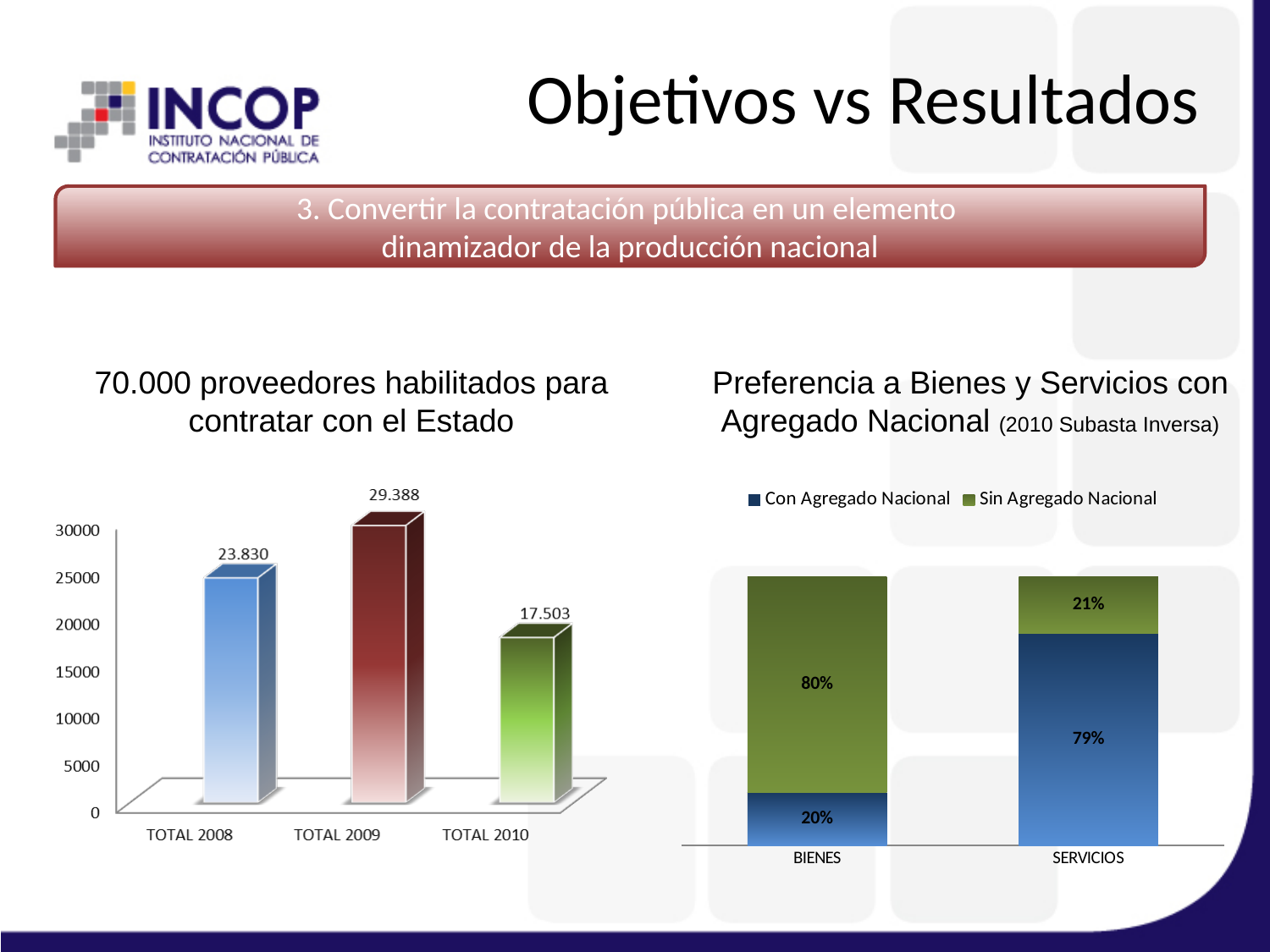
In the right chart (Preferencia a Bienes y Servicios con Agregado Nacional), what is the Con Agregado Nacional share for SERVICIOS? 79% In the left chart (70.000 proveedores habilitados), what is the value for TOTAL 2009? 29.388 In the right chart (Preferencia a Bienes y Servicios con Agregado Nacional), what is the Sin Agregado Nacional share for BIENES? 80% In the left chart (70.000 proveedores habilitados), which category has the lowest value? TOTAL 2010 In the left chart (70.000 proveedores habilitados), what is the difference between TOTAL 2009 and TOTAL 2008? 5.558 In the left chart (70.000 proveedores habilitados), what is the value for TOTAL 2010? 17.503 What kind of chart is the left chart (70.000 proveedores habilitados)? Bar chart In the right chart (Preferencia a Bienes y Servicios con Agregado Nacional), how many series does the legend list? 2 In the right chart (Preferencia a Bienes y Servicios con Agregado Nacional), which is larger for BIENES: Con Agregado Nacional or Sin Agregado Nacional? Sin Agregado Nacional In the left chart (70.000 proveedores habilitados), which category has the highest value? TOTAL 2009 In the left chart (70.000 proveedores habilitados), how many categories are shown on the x axis? 3 In the right chart (Preferencia a Bienes y Servicios con Agregado Nacional), which colour represents Con Agregado Nacional? Blue